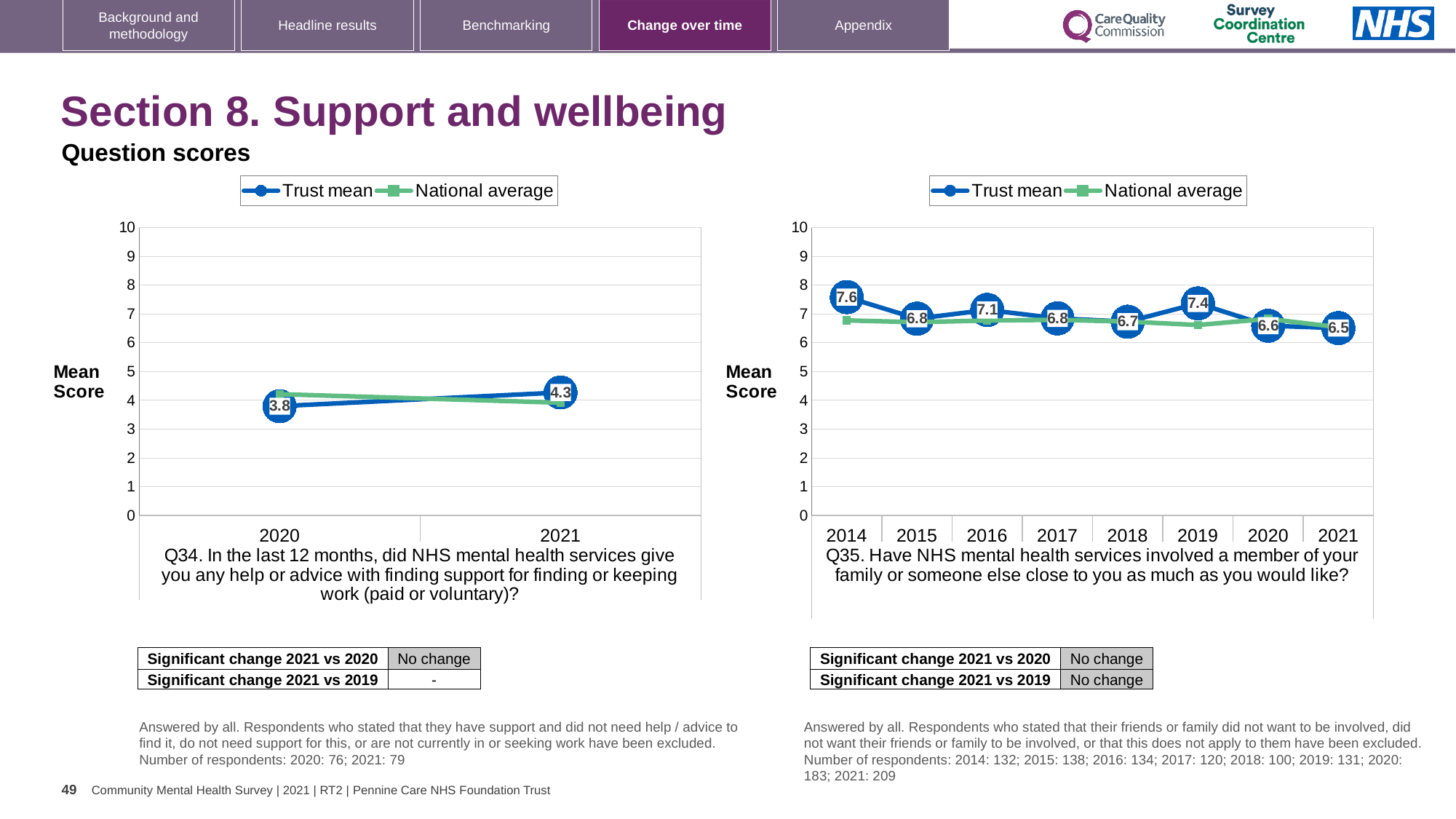
In the Q35 chart on the right, what is the Trust mean score for 2019? 7.4 In the Q34 chart on the left, what is the Trust mean score for 2020? 3.8 In the Q34 chart on the left, what is the Trust mean score for 2021? 4.3 In the Q35 chart on the right, which year has the lowest Trust mean score? 2021 In the Q35 chart on the right, which year has the highest Trust mean score? 2014 In the Q34 chart on the left, by how much did the Trust mean change from 2020 to 2021? 0.5 What type of chart is the Q35 chart on the right? Line chart In the Q35 chart on the right, what is the difference between the Trust mean in 2014 and in 2021? 1.1 In the Q35 chart on the right, what is the Trust mean score for 2014? 7.6 In the Q35 chart on the right, how many years are shown on the x axis? 8 In the Q35 chart on the right, is the Trust mean higher in 2016 or in 2018? 2016 How many series does the legend of the Q34 chart on the left list? 2